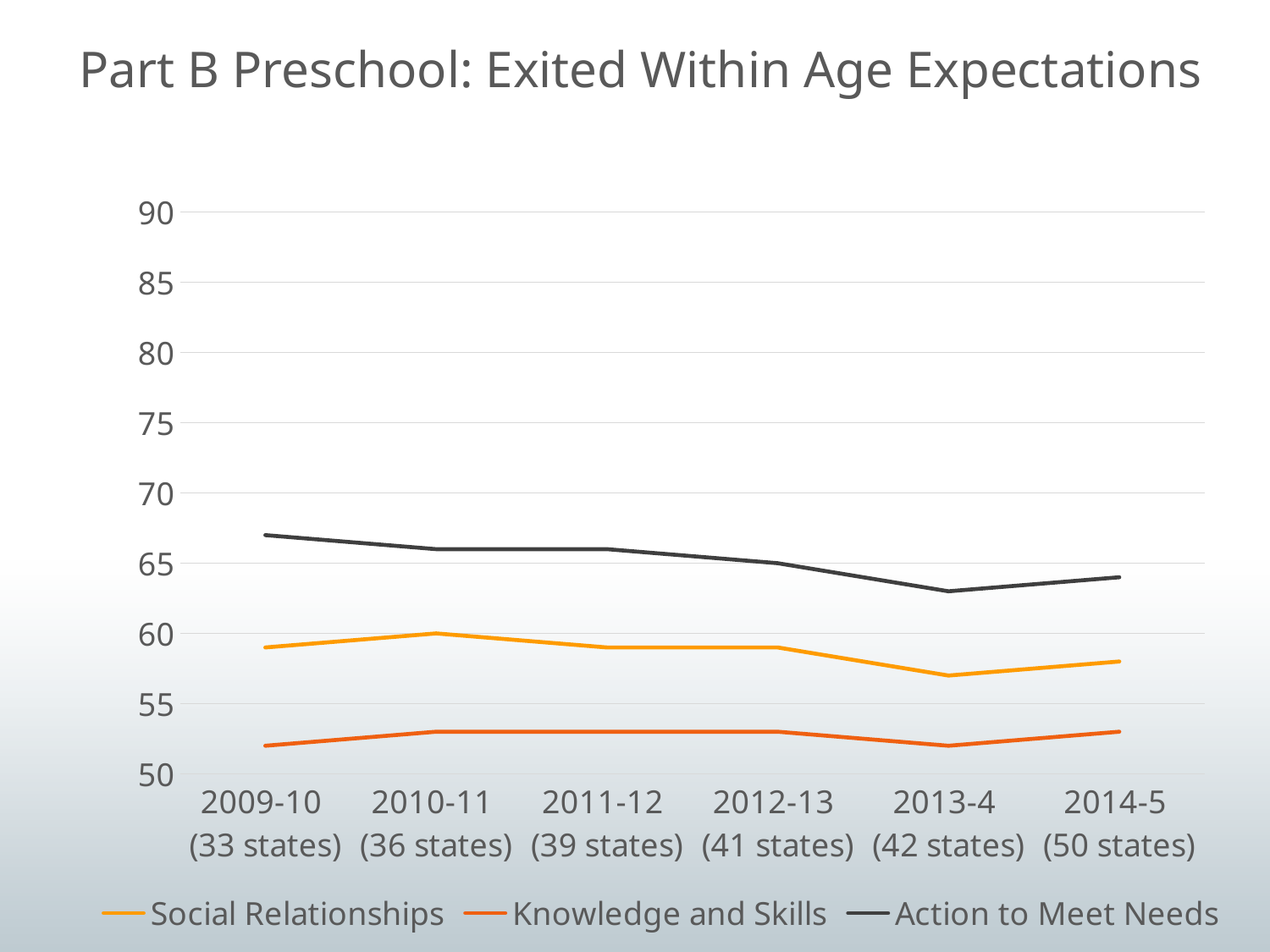
Which is larger in 2014-5: Social Relationships or Knowledge and Skills? Social Relationships Is the value for Action to Meet Needs in 2013-4 greater or less than 60? greater How many series does the legend list? 3 Which series has the highest values across all years? Action to Meet Needs Is the value for Action to Meet Needs in 2009-10 greater or less than 65? greater How many time periods are shown on the x axis? 6 Does the Action to Meet Needs line generally rise or fall from 2009-10 to 2013-4? fall Which series has the lowest values across all years? Knowledge and Skills Is the value for Knowledge and Skills in 2013-4 greater or less than 55? less What is the title of the chart? Part B Preschool: Exited Within Age Expectations What kind of chart is shown on the slide? line chart